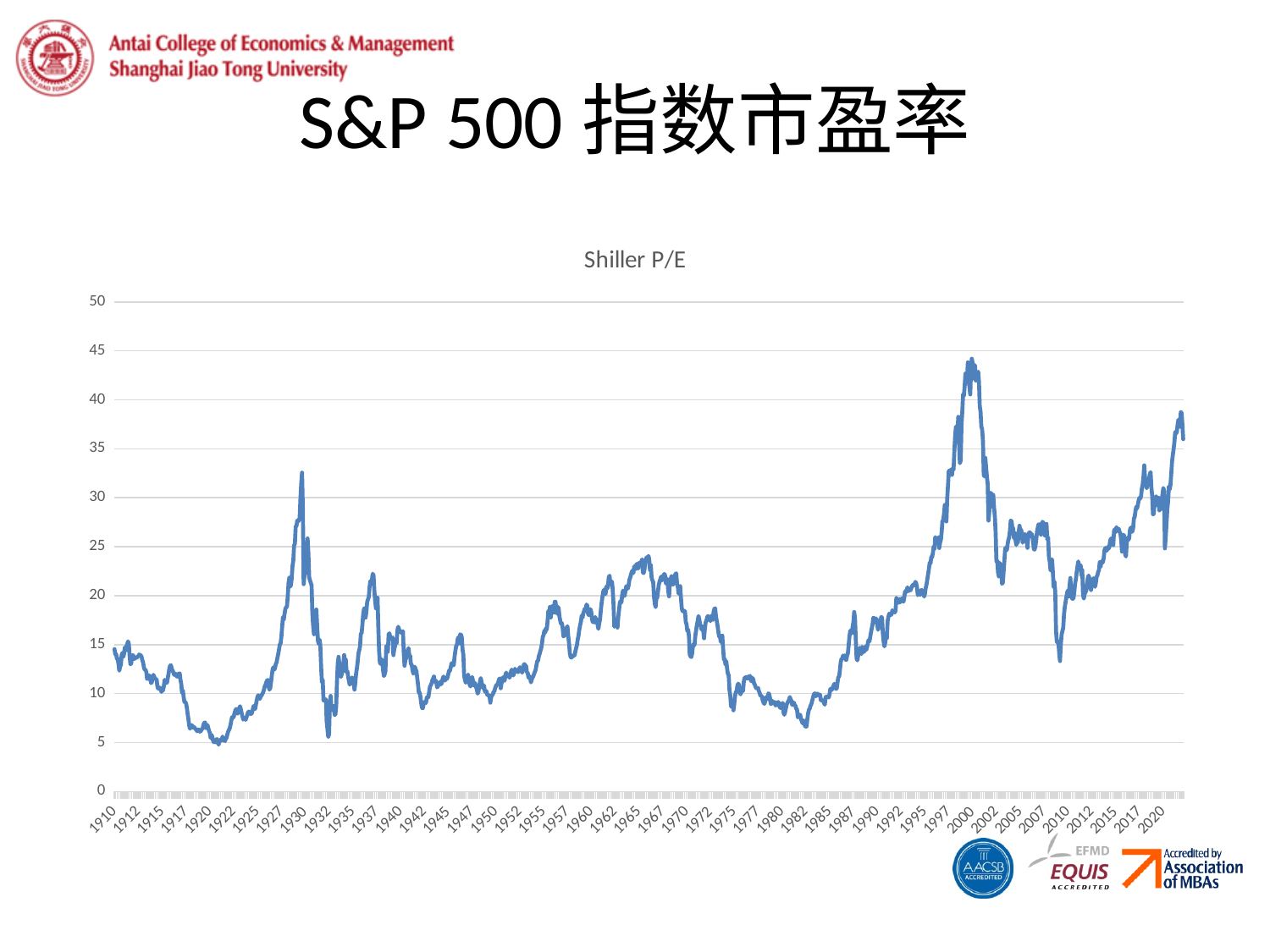
Around which year does the Shiller P/E reach its highest value? 2000 Around which year does the Shiller P/E reach its lowest value? 1920 How many data series are plotted in the chart? 1 Is the Shiller P/E value around the year 1921 greater or less than 10? less What kind of chart is shown on the slide? line chart What is the title of the chart? Shiller P/E Is the Shiller P/E value around the year 1950 greater or less than 15? less Is the Shiller P/E value around the year 1982 greater or less than 10? less Does the Shiller P/E generally rise or fall between 1982 and 2000? rise Which peak is higher, the one around 1929 or the one around 2000? 2000